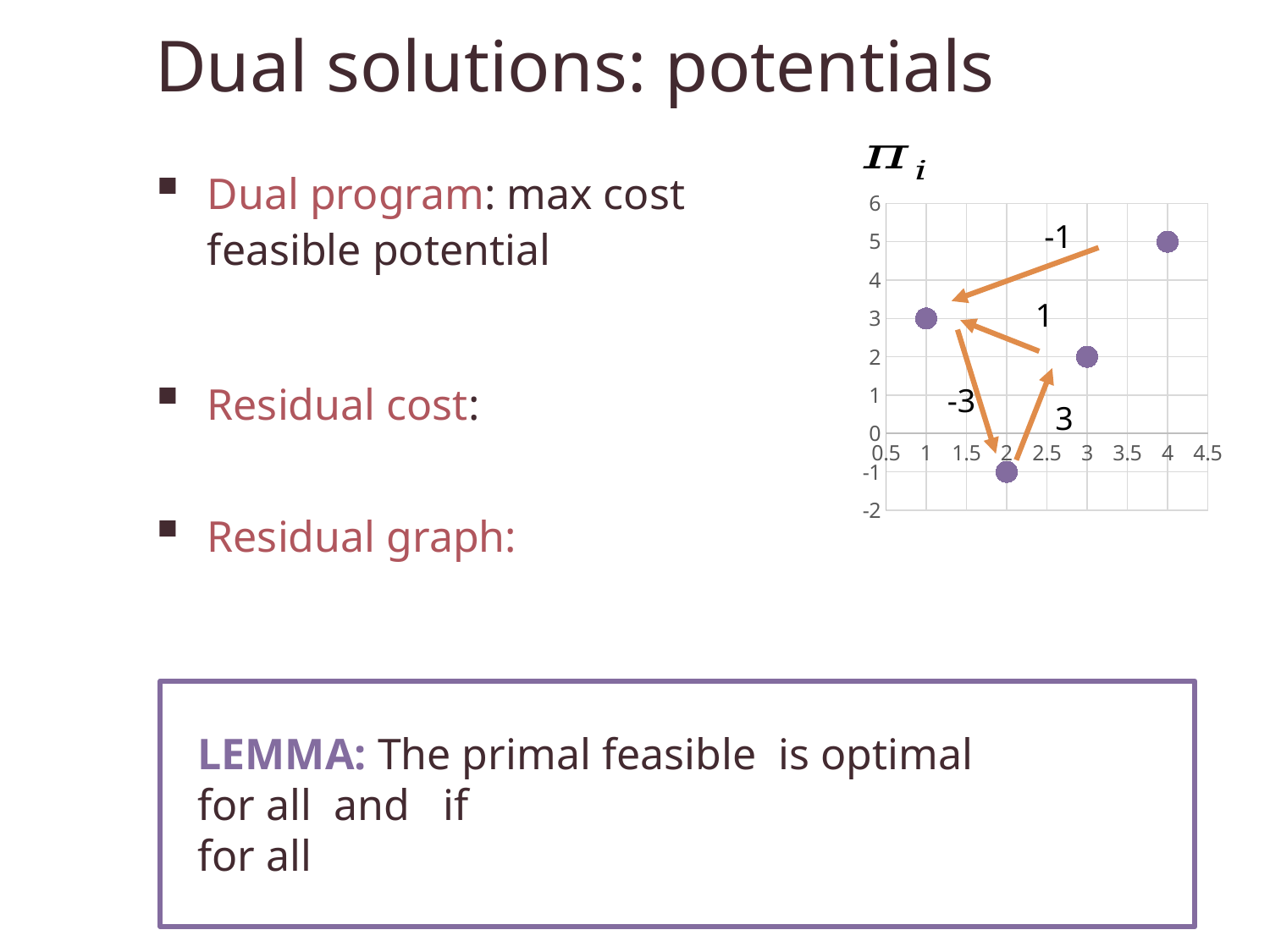
What is the difference between the y value at x = 4 and the y value at x = 2? 6 How many data points are plotted in the chart? 4 What is the y value of the point at x = 4? 5 What is the y value of the point at x = 2? -1 What kind of chart is shown on the slide? scatter chart How many arrows are drawn between the points in the chart? 4 What is the y value of the point at x = 1? 3 What is the y value of the point at x = 3? 2 Which point has the larger y value, the one at x = 1 or the one at x = 3? x = 1 At which x value is the highest point plotted? 4 Is the y value of the point at x = 4 greater or less than 4? greater At which x value is the lowest point plotted? 2